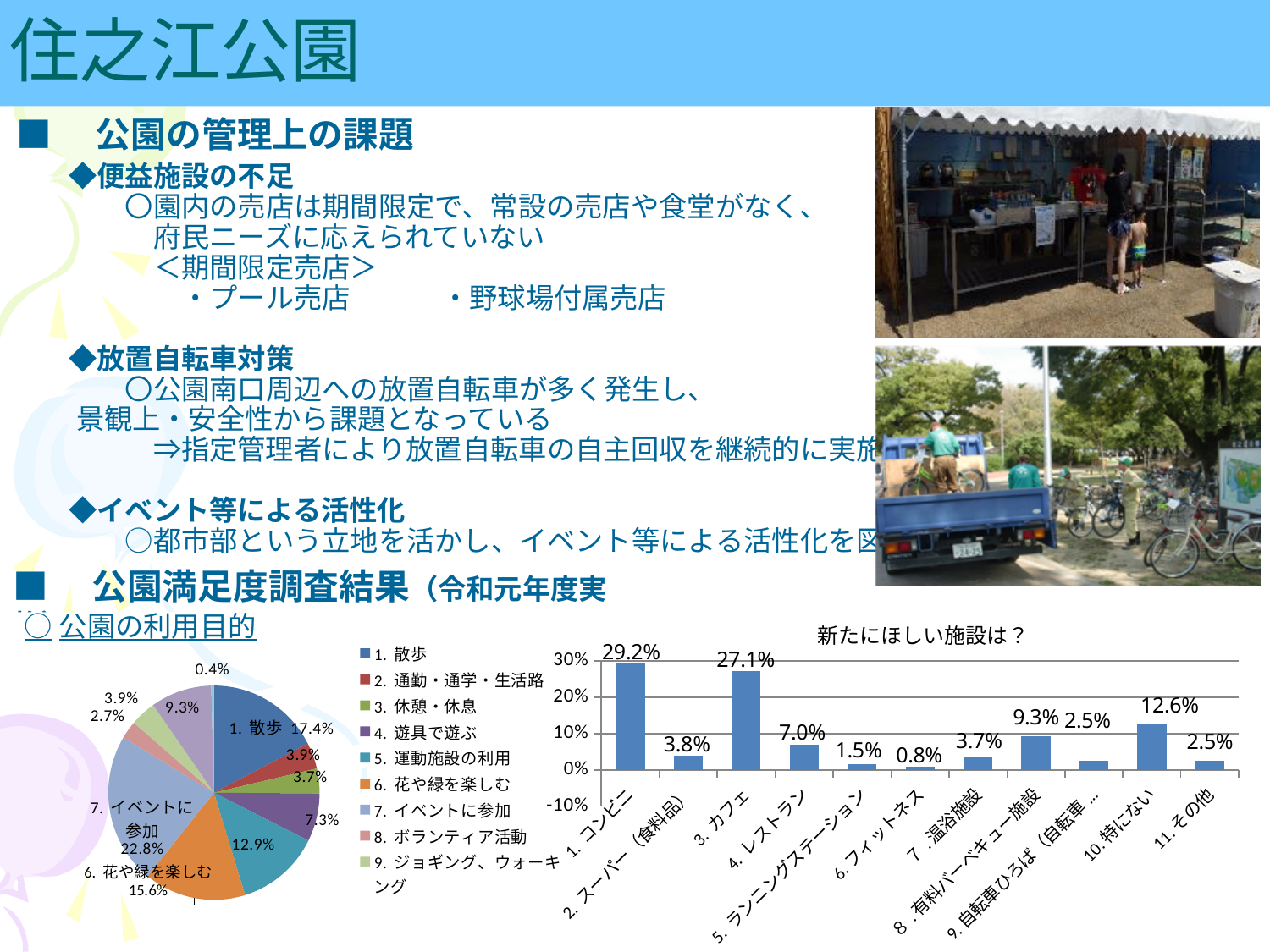
How many categories are shown in the bar chart titled 新たにほしい施設は？? 11 What kind of chart is the chart on the left labelled 公園の利用目的? pie chart In the bar chart titled 新たにほしい施設は？, what is the value for 10. 特にない? 12.6% In the bar chart titled 新たにほしい施設は？, what is the value for 3. カフェ? 27.1% In the bar chart titled 新たにほしい施設は？, which category has the lowest value? 6. フィットネス What kind of chart is the chart titled 新たにほしい施設は？? bar chart In the bar chart titled 新たにほしい施設は？, which is larger, the value for 4. レストラン or the value for 8. 有料バーベキュー施設? 8. 有料バーベキュー施設 In the pie chart 公園の利用目的, what is the share for 1. 散歩? 17.4% In the pie chart 公園の利用目的, what is the share for 7. イベントに参加? 22.8% In the bar chart titled 新たにほしい施設は？, which category has the highest value? 1. コンビニ In the bar chart titled 新たにほしい施設は？, what is the difference between the values for 1. コンビニ and 3. カフェ? 2.1% In the bar chart titled 新たにほしい施設は？, what is the value for 1. コンビニ? 29.2%